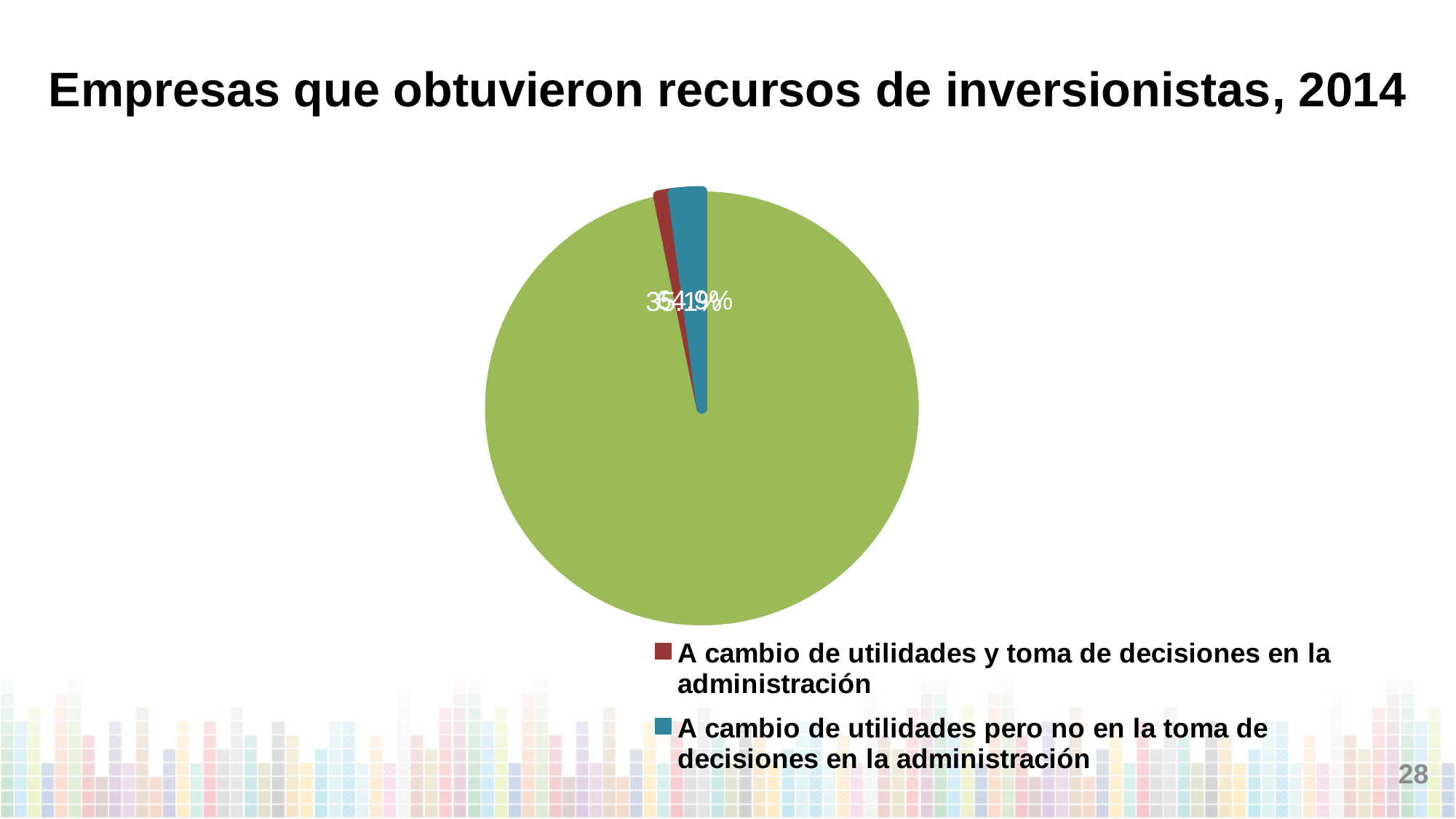
What kind of chart is shown on the slide? pie chart Which colour represents "A cambio de utilidades pero no en la toma de decisiones en la administración" in the pie chart? blue How many entries does the legend of the pie chart list? 2 How many slices does the pie chart have? 3 What is the title of the slide containing the pie chart? Empresas que obtuvieron recursos de inversionistas, 2014 Is the slice for "A cambio de utilidades pero no en la toma de decisiones en la administración" greater or less than half of the pie? less Is the slice for "A cambio de utilidades y toma de decisiones en la administración" greater or less than half of the pie? less